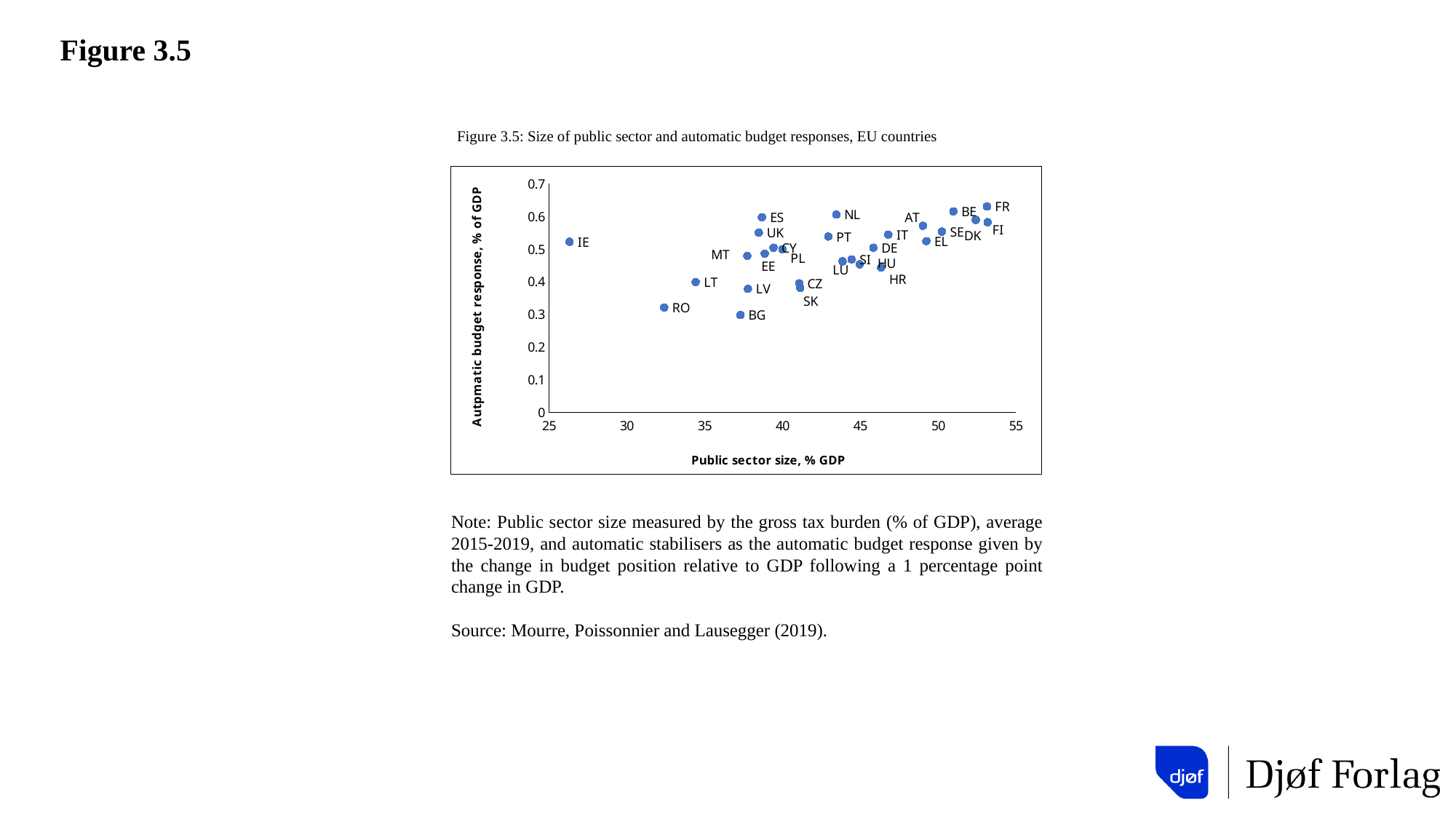
What is the label of the x axis? Public sector size, % GDP Is the public sector size for RO greater or less than 35? less How many country points are plotted on the chart? 28 Do automatic budget responses generally rise or fall as public sector size increases? rise Which country has the highest automatic budget response? FR What kind of chart is shown in Figure 3.5? scatter chart Is the public sector size for FR greater or less than 50? greater Which has the larger automatic budget response, ES or LV? ES Is the automatic budget response for IE greater or less than 0.5? greater Which country has the smallest public sector size? IE What is the title of the chart? Figure 3.5: Size of public sector and automatic budget responses, EU countries